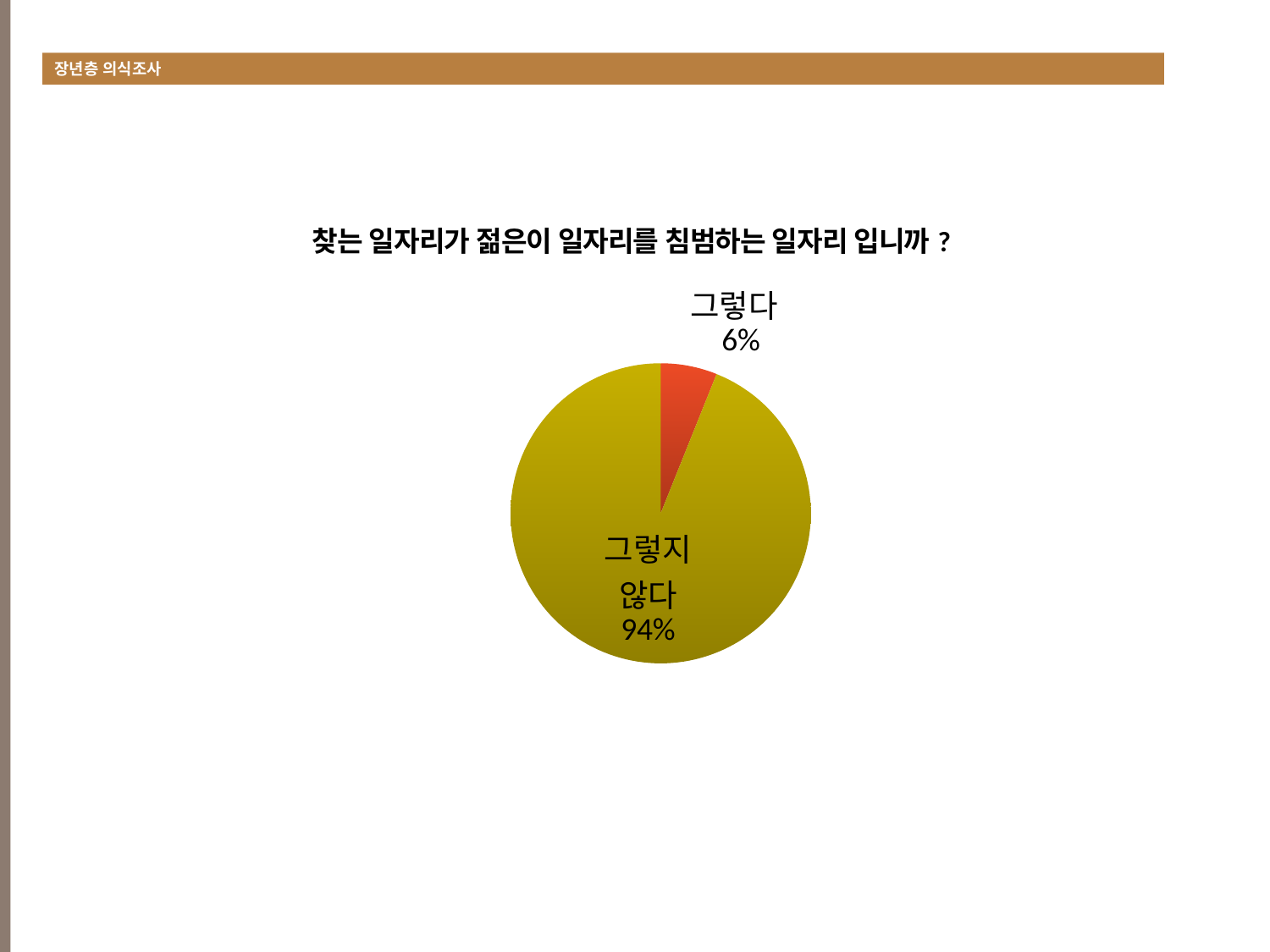
What is the title of the chart? 찾는 일자리가 젊은이 일자리를 침범하는 일자리 입니까 ? What colour is the 그렇다 slice? red-orange What share of the pie does the 그렇다 slice represent? 6% What percentage of respondents answered 그렇지 않다? 94% How many slices does the pie chart have? 2 What kind of chart is shown on the slide? pie chart Which is larger, the share for 그렇다 or the share for 그렇지 않다? 그렇지 않다 What percentage of respondents answered 그렇다? 6% Which response has the largest share of the pie? 그렇지 않다 Which response has the smallest share of the pie? 그렇다 What is the difference in percentage points between 그렇지 않다 and 그렇다? 88